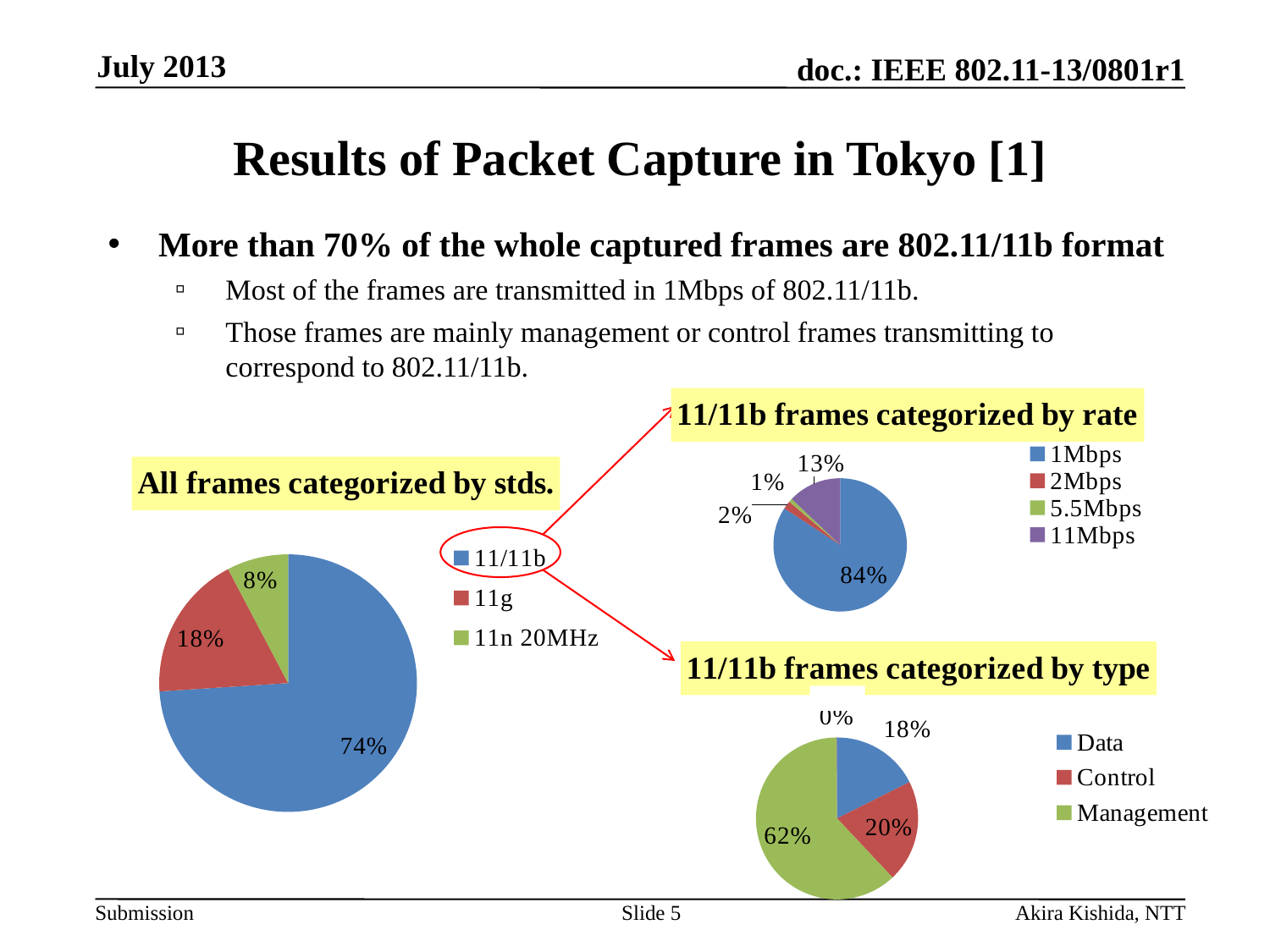
In the '11/11b frames categorized by type' pie chart, what share of frames is Management? 62% How many rate categories does the legend of the '11/11b frames categorized by rate' chart list? 4 In the '11/11b frames categorized by rate' pie chart, which rate has the largest share? 1Mbps In the 'All frames categorized by stds.' pie chart, what share of frames is 11g? 18% In the 'All frames categorized by stds.' pie chart, what is the difference between the 11/11b share and the 11g share? 56% In the 'All frames categorized by stds.' pie chart, what share of frames is 11/11b? 74% In the 'All frames categorized by stds.' pie chart, which category has the smallest share? 11n 20MHz How many categories does the legend of the 'All frames categorized by stds.' chart list? 3 In the '11/11b frames categorized by rate' pie chart, what share of frames is 11Mbps? 13% What type of chart is used for 'All frames categorized by stds.'? Pie chart In the '11/11b frames categorized by rate' pie chart, what share of frames is 1Mbps? 84% In the '11/11b frames categorized by type' pie chart, which is larger, Data or Control? Control